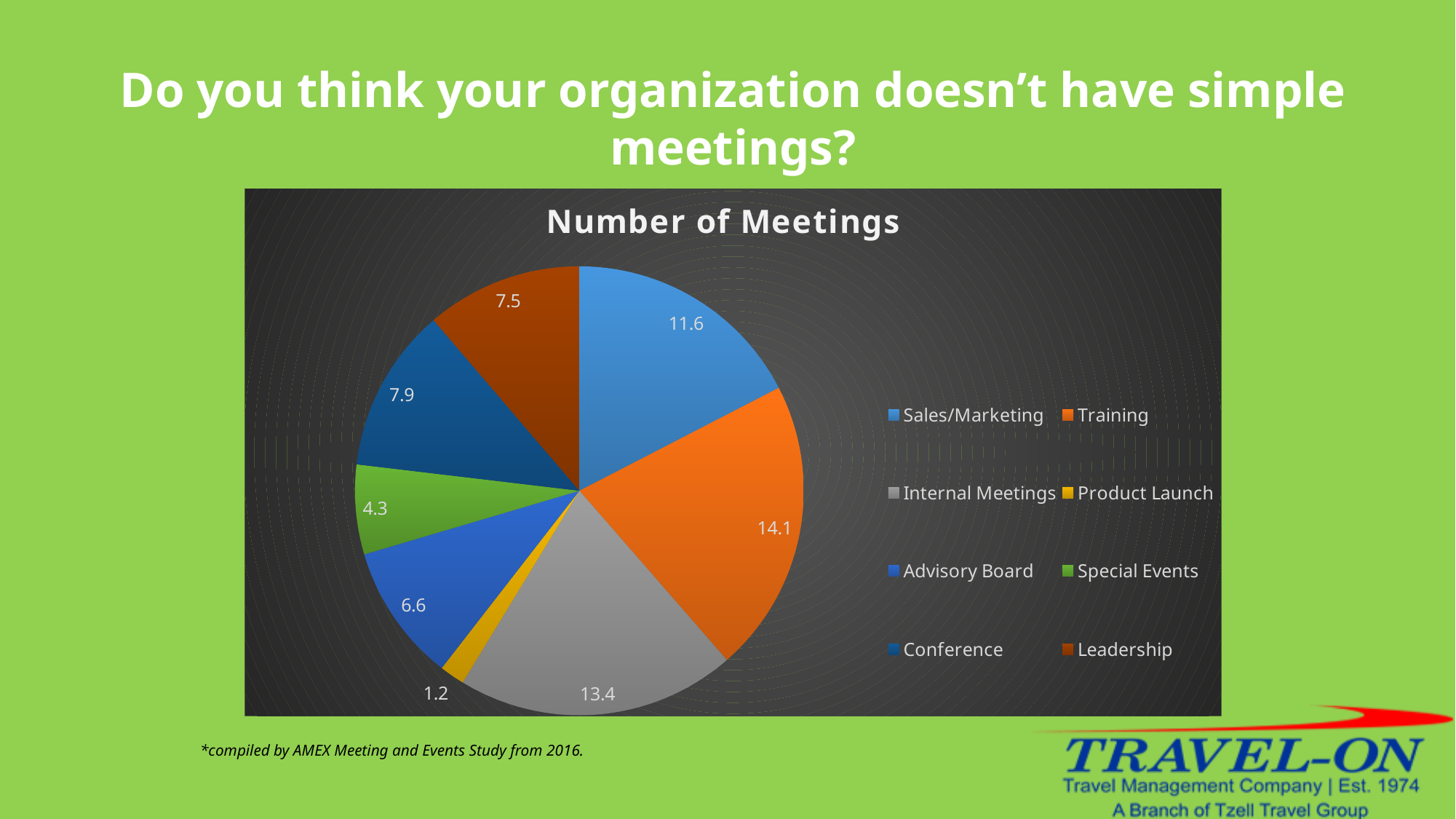
Which category has the largest slice in the Number of Meetings pie chart? Training What is the value for Internal Meetings in the pie chart? 13.4 What is the difference between the values for Conference and Advisory Board? 1.3 Which category has the smallest slice in the Number of Meetings pie chart? Product Launch What is the difference between the values for Training and Sales/Marketing? 2.5 What is the value for Special Events in the pie chart? 4.3 What type of chart is shown on the slide? Pie chart What is the value for Training in the Number of Meetings pie chart? 14.1 Which is larger, the value for Conference or the value for Leadership? Conference What is the title of the chart on the slide? Number of Meetings How many categories are shown in the Number of Meetings pie chart? 8 What is the value for Product Launch in the pie chart? 1.2